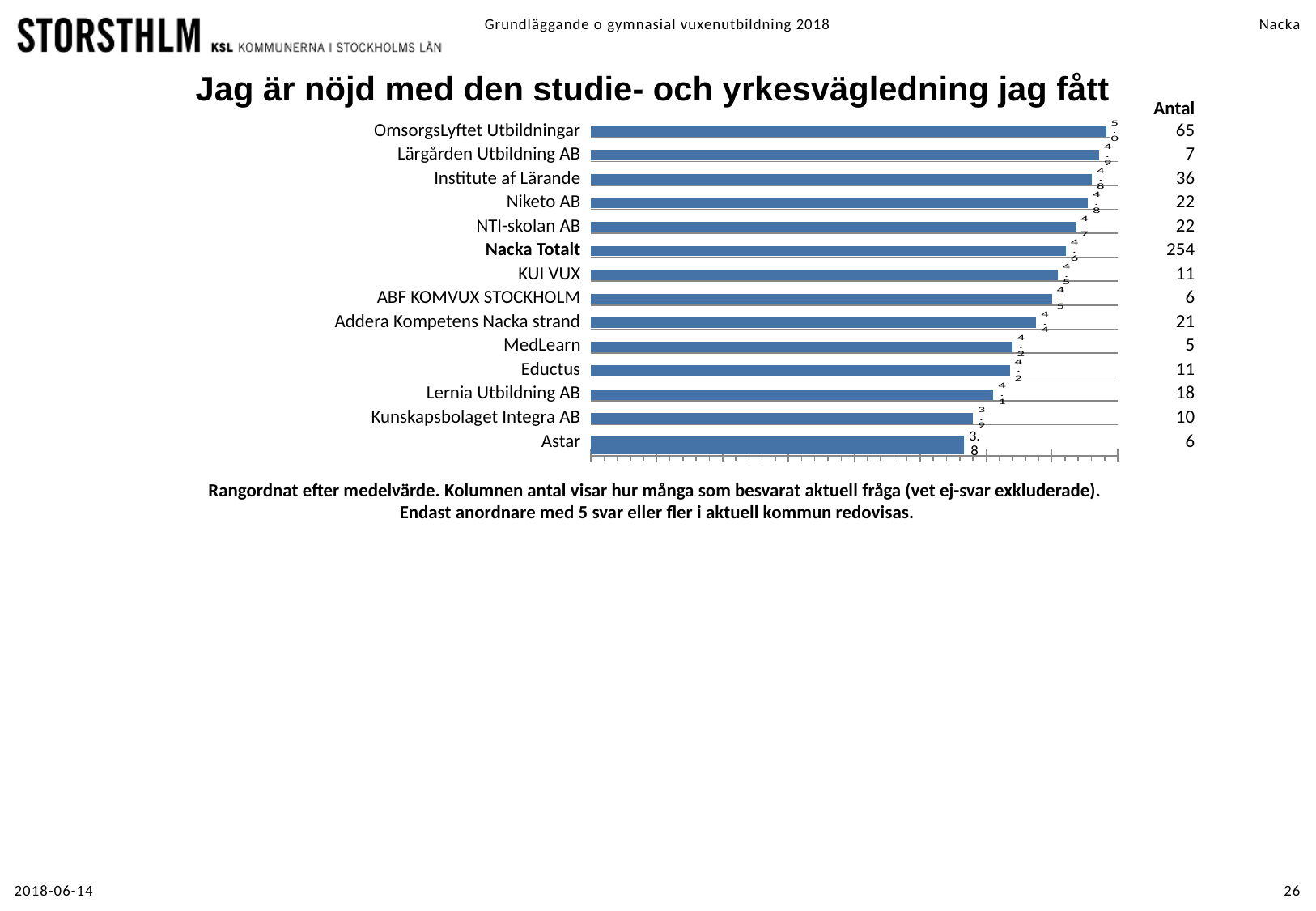
Do the values rise or fall going from the top category to the bottom category? fall What is the difference between the values for OmsorgsLyftet Utbildningar and Astar? 1.2 What is the value for OmsorgsLyftet Utbildningar? 5.0 How many categories (providers) are plotted in the chart? 14 Which category has the lowest value in the chart? Astar Which category has the highest value in the chart? OmsorgsLyftet Utbildningar What is the value for Lernia Utbildning AB? 4.1 Which has a larger value, Lärgården Utbildning AB or Kunskapsbolaget Integra AB? Lärgården Utbildning AB What is the value for Astar? 3.8 What kind of chart is shown on the slide? bar chart What is the value for Nacka Totalt? 4.6 What is the title of the chart? Jag är nöjd med den studie- och yrkesvägledning jag fått